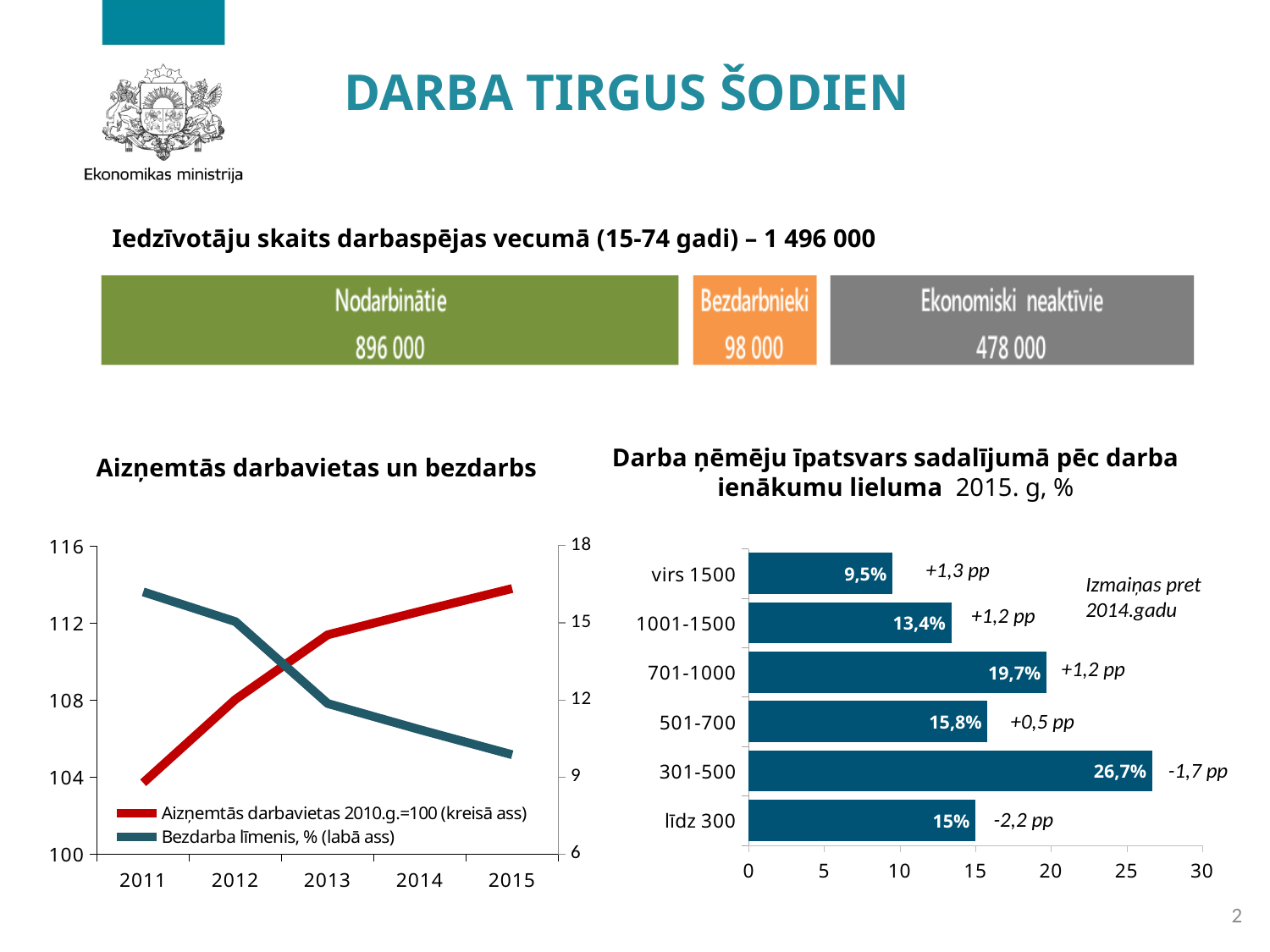
In the chart 'Darba ņēmēju īpatsvars sadalījumā pēc darba ienākumu lieluma', which income category has the highest share? 301-500 What kind of chart is 'Aizņemtās darbavietas un bezdarbs'? Line chart How many series does the legend of the chart 'Aizņemtās darbavietas un bezdarbs' list? 2 In the chart 'Darba ņēmēju īpatsvars sadalījumā pēc darba ienākumu lieluma', what is the value for the 301-500 category? 26,7% In the chart 'Darba ņēmēju īpatsvars sadalījumā pēc darba ienākumu lieluma', which is larger: the value for 1001-1500 or for 'līdz 300'? līdz 300 In the chart 'Aizņemtās darbavietas un bezdarbs', does the 'Bezdarba līmenis' series rise or fall from 2011 to 2015? Fall In the chart 'Aizņemtās darbavietas un bezdarbs', is the 'Aizņemtās darbavietas' value for 2015 greater or less than 112? greater In the chart 'Darba ņēmēju īpatsvars sadalījumā pēc darba ienākumu lieluma', what is the difference between the 701-1000 and 501-700 values? 3,9 percentage points In the chart 'Darba ņēmēju īpatsvars sadalījumā pēc darba ienākumu lieluma', which income category has the lowest share? virs 1500 In the chart 'Darba ņēmēju īpatsvars sadalījumā pēc darba ienākumu lieluma', what is the value for 'virs 1500'? 9,5% In the chart 'Darba ņēmēju īpatsvars sadalījumā pēc darba ienākumu lieluma', how many income categories are shown? 6 In the chart 'Darba ņēmēju īpatsvars sadalījumā pēc darba ienākumu lieluma', what change versus 2014 is shown next to the 'līdz 300' bar? -2,2 pp